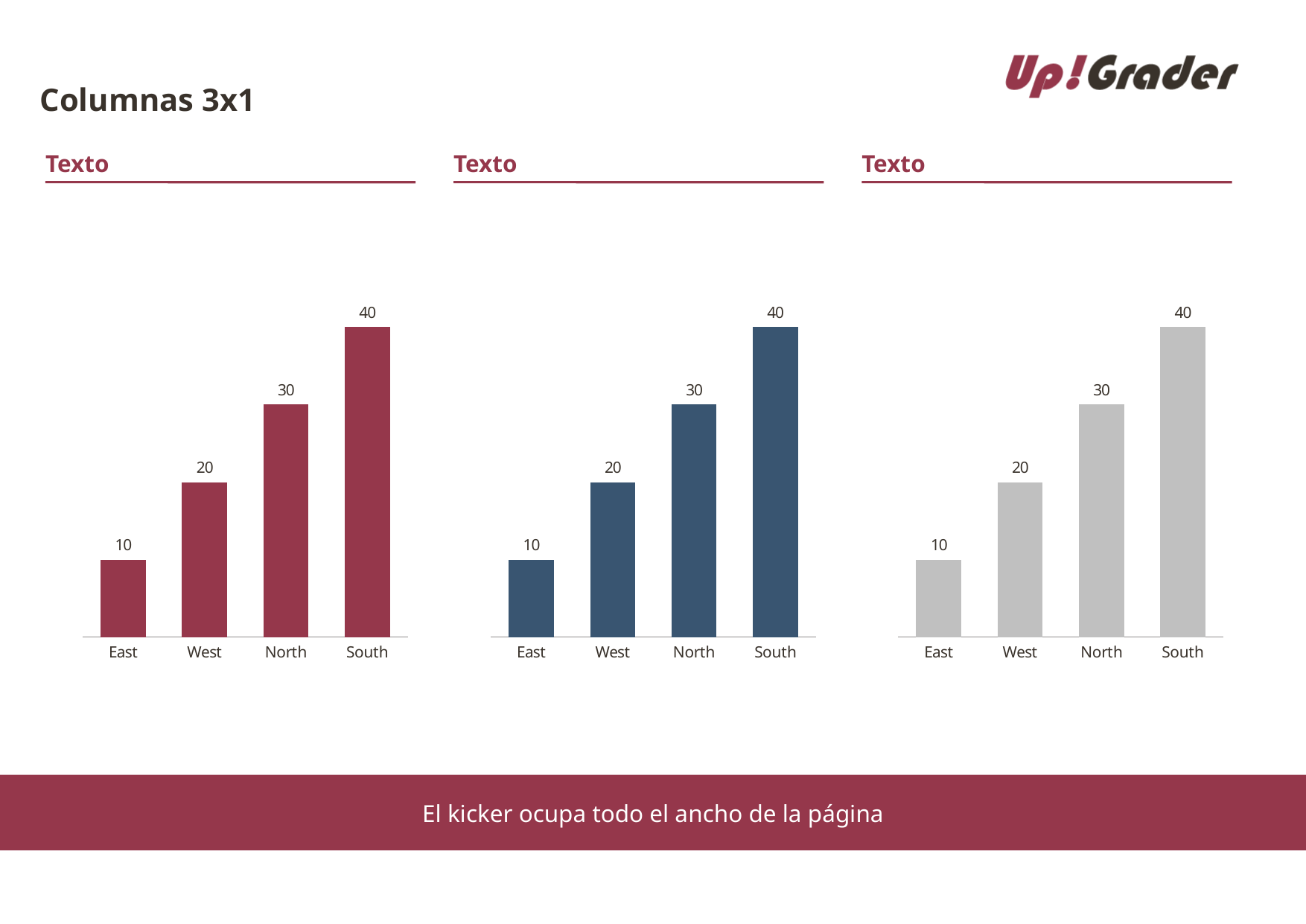
In the middle chart, which category has the lowest value? East What colour are the bars in the middle chart? dark blue In the left chart, which is larger, the value for West or the value for North? North How many charts are on the slide? 3 In the left chart, what is the value for North? 30 In the right chart, what is the value for West? 20 In the middle chart, do the values rise or fall from East to South? rise In the right chart, what is the difference between the values for South and East? 30 In the left chart, which category has the highest value? South How many categories are shown in the middle chart? 4 What kind of chart is the right chart? bar chart In the middle chart, what is the value for East? 10